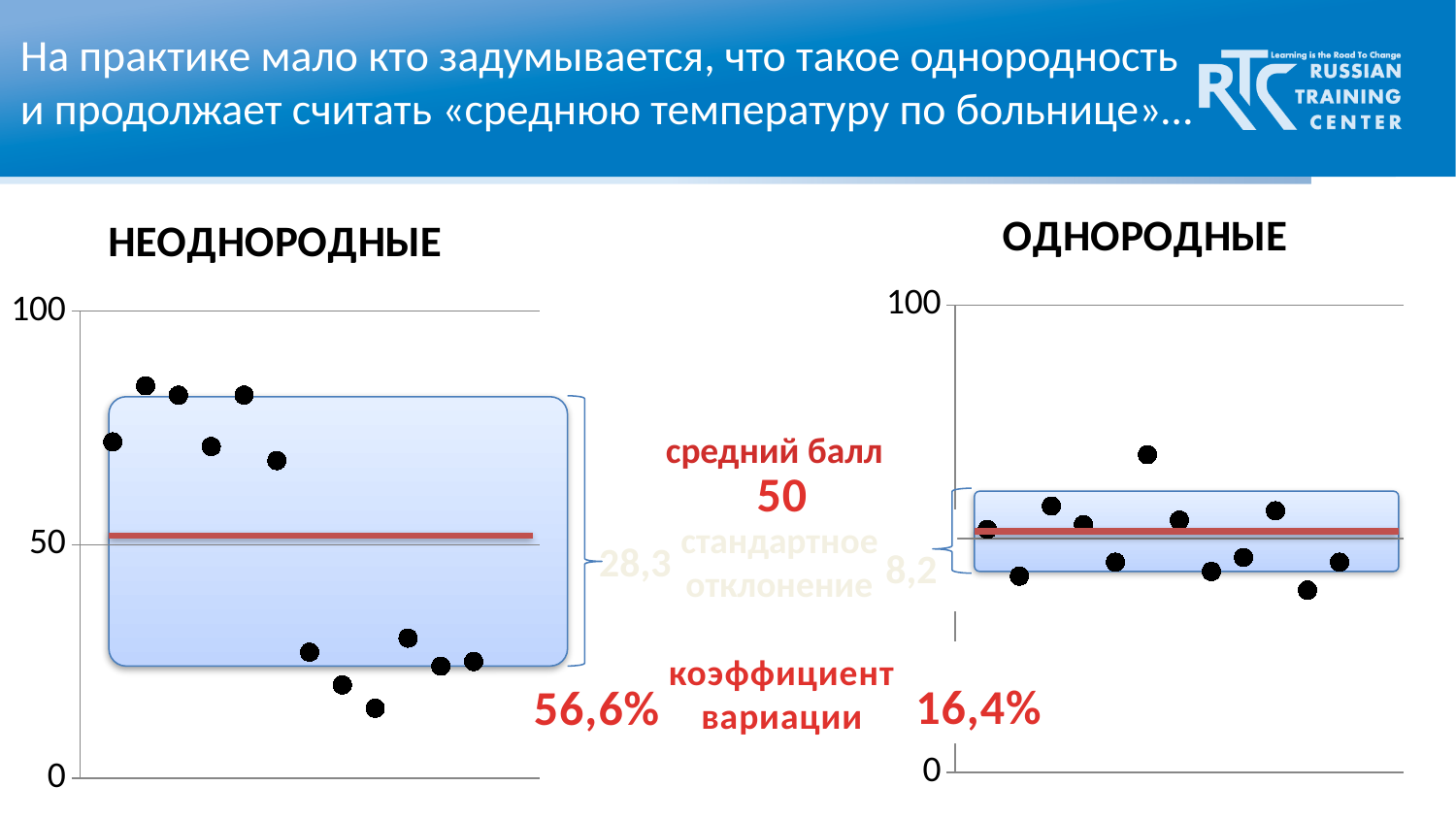
In the ОДНОРОДНЫЕ chart, is the highest plotted point greater or less than 50? greater What is the стандартное отклонение (standard deviation) shown for the ОДНОРОДНЫЕ chart? 8,2 In the НЕОДНОРОДНЫЕ chart, is the lowest plotted point greater or less than 50? less What is the средний балл (mean score) shown between the two charts? 50 What is the стандартное отклонение (standard deviation) shown for the НЕОДНОРОДНЫЕ chart? 28,3 What is the difference between the two коэффициент вариации values shown (56,6% and 16,4%)? 40,2% What is the maximum value shown on the vertical axis of the НЕОДНОРОДНЫЕ chart? 100 What is the коэффициент вариации (coefficient of variation) shown for the ОДНОРОДНЫЕ chart? 16,4% What kind of chart is the НЕОДНОРОДНЫЕ chart on the left? scatter chart What is the коэффициент вариации (coefficient of variation) shown for the НЕОДНОРОДНЫЕ chart? 56,6% Which chart has the larger коэффициент вариации, НЕОДНОРОДНЫЕ or ОДНОРОДНЫЕ? НЕОДНОРОДНЫЕ How many data points are plotted in the ОДНОРОДНЫЕ chart? 12